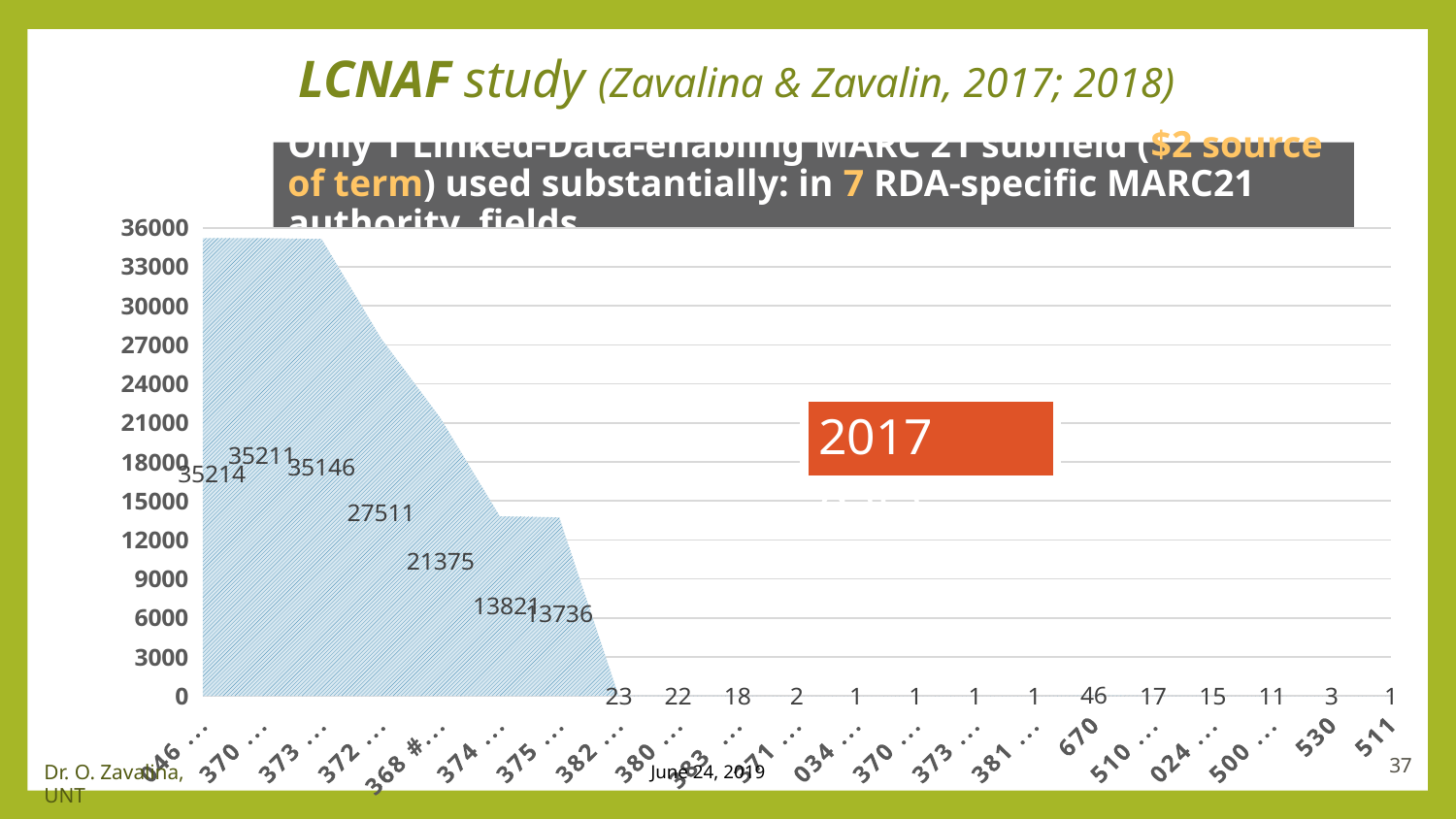
How many categories are plotted along the x axis? 21 What is the value for the first category, "046 ..."? 35214 Is the value for "372 ..." greater or less than 24000? greater What is the value for the category "670 ..."? 46 What is the value for the category "368 #..."? 21375 What kind of chart is shown on the slide? area chart Do the values generally rise or fall from left to right along the x axis? fall What is the difference between the value for "046 ..." (35214) and the value for "375 ..." (13736)? 21478 What is the value for the category "530 ..."? 3 Which is larger, the value for "670 ..." or the value for "382 ..."? 670 ... Which category has the highest value? 046 ... What is the difference between the value for "372 ..." (27511) and the value for "368 #..." (21375)? 6136